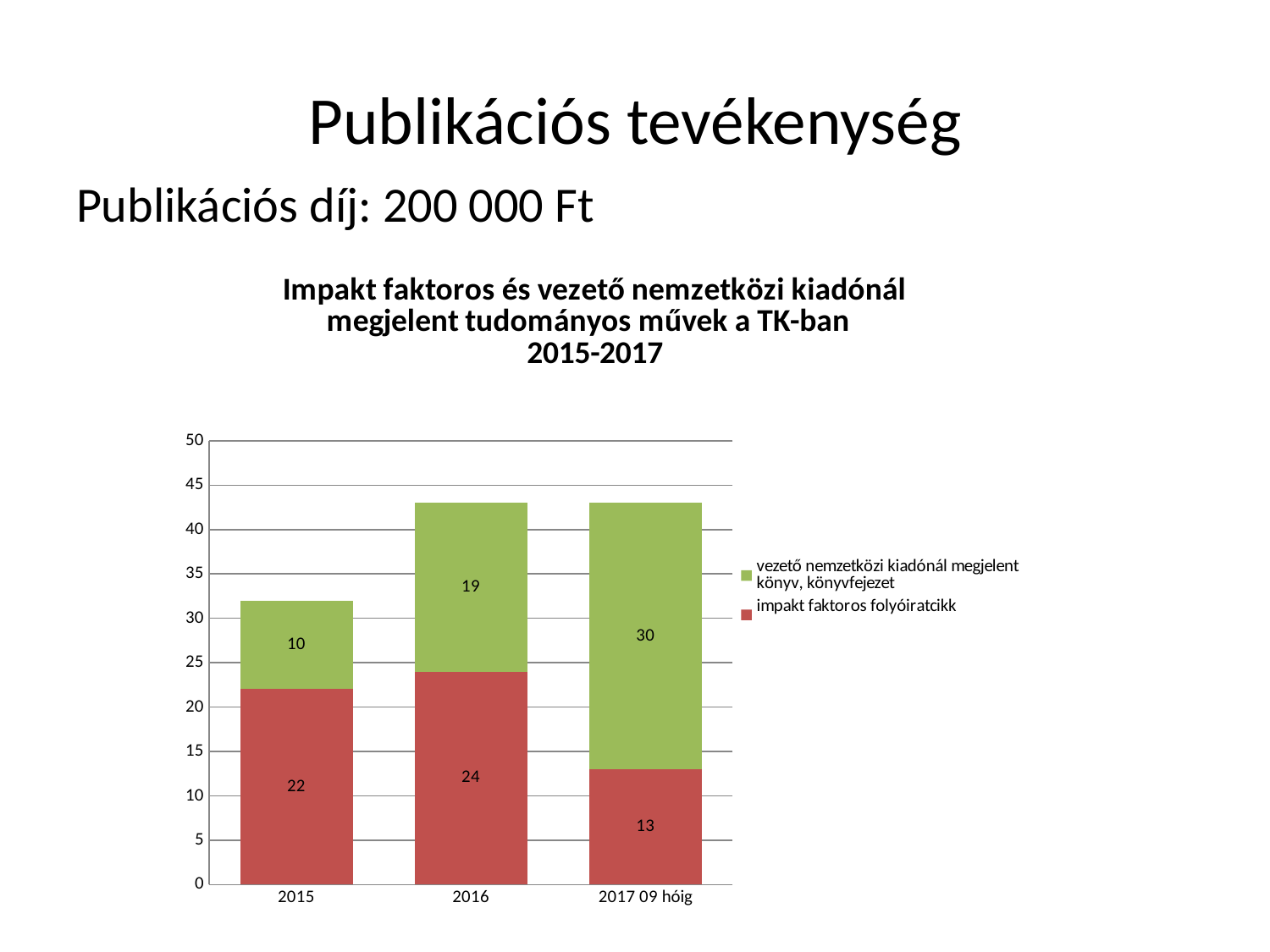
How many series does the legend list? 2 What is the total of the stacked bar for 2015? 32 What kind of chart is shown on the slide? stacked bar chart How many categories are shown on the x axis? 3 What is the total of the stacked bar for 2016? 43 Which is larger: 'impakt faktoros folyóiratcikk' in 2015 or 'vezető nemzetközi kiadónál megjelent könyv, könyvfejezet' in 2015? impakt faktoros folyóiratcikk What is the value for 'impakt faktoros folyóiratcikk' in 2015? 22 Which year has the highest value for 'vezető nemzetközi kiadónál megjelent könyv, könyvfejezet'? 2017 09 hóig Which year has the lowest value for 'impakt faktoros folyóiratcikk'? 2017 09 hóig What is the difference between the 'impakt faktoros folyóiratcikk' values for 2016 and 2015? 2 What is the value for 'impakt faktoros folyóiratcikk' in 2016? 24 What is the value for 'vezető nemzetközi kiadónál megjelent könyv, könyvfejezet' in 2017 09 hóig? 30